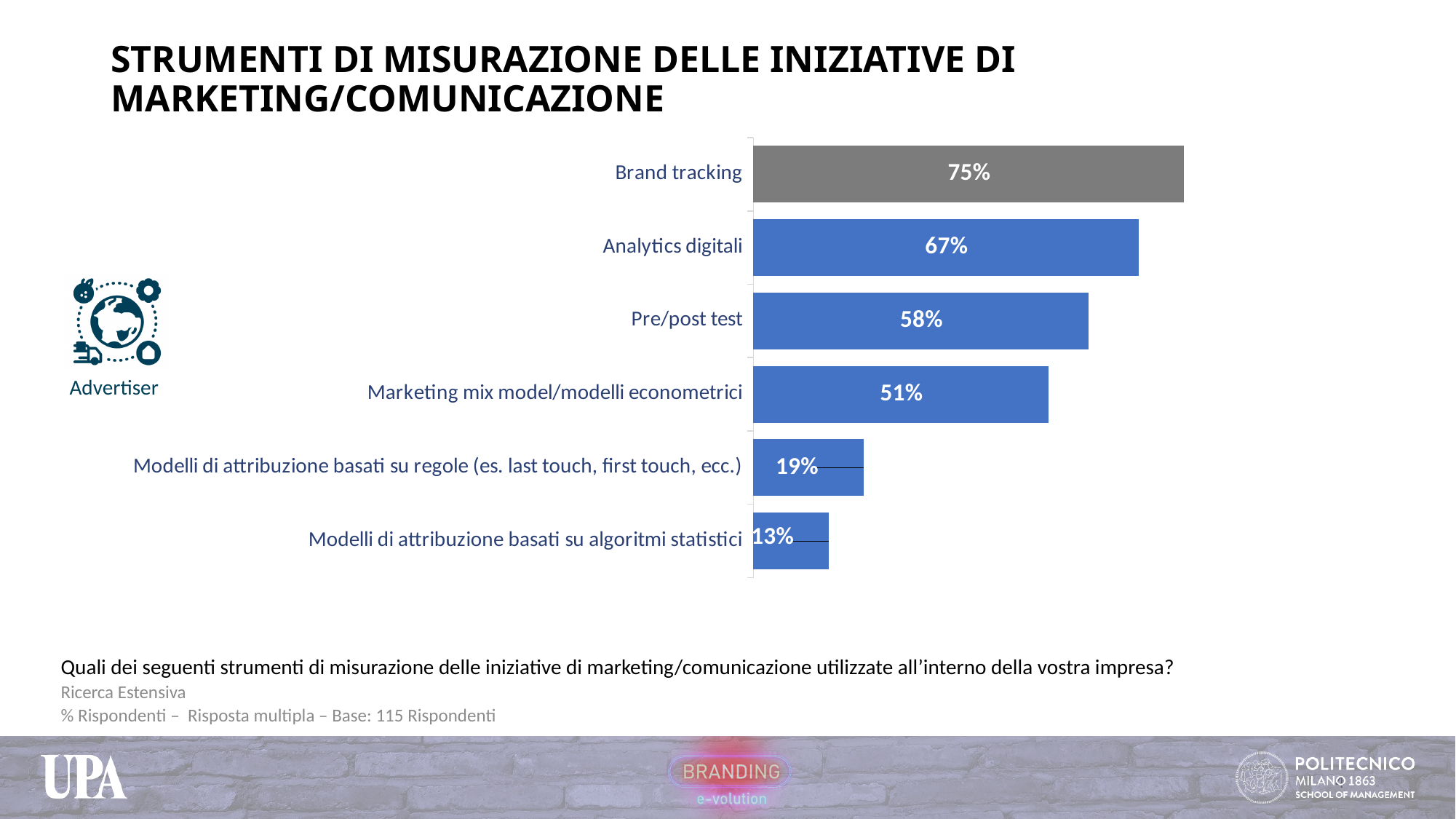
What is the value for Brand tracking? 75% Which is larger, the value for Pre/post test or the value for Marketing mix model/modelli econometrici? Pre/post test What is the value for Marketing mix model/modelli econometrici? 51% What is the difference between the values for Modelli di attribuzione basati su regole (es. last touch, first touch, ecc.) and Modelli di attribuzione basati su algoritmi statistici? 6% What is the value for Modelli di attribuzione basati su algoritmi statistici? 13% Which category has the highest value? Brand tracking What kind of chart is shown on the slide? Bar chart What is the value for Pre/post test? 58% What is the difference between the values for Brand tracking and Analytics digitali? 8% What is the value for Analytics digitali? 67% How many categories are shown in the chart? 6 Which category has the lowest value? Modelli di attribuzione basati su algoritmi statistici